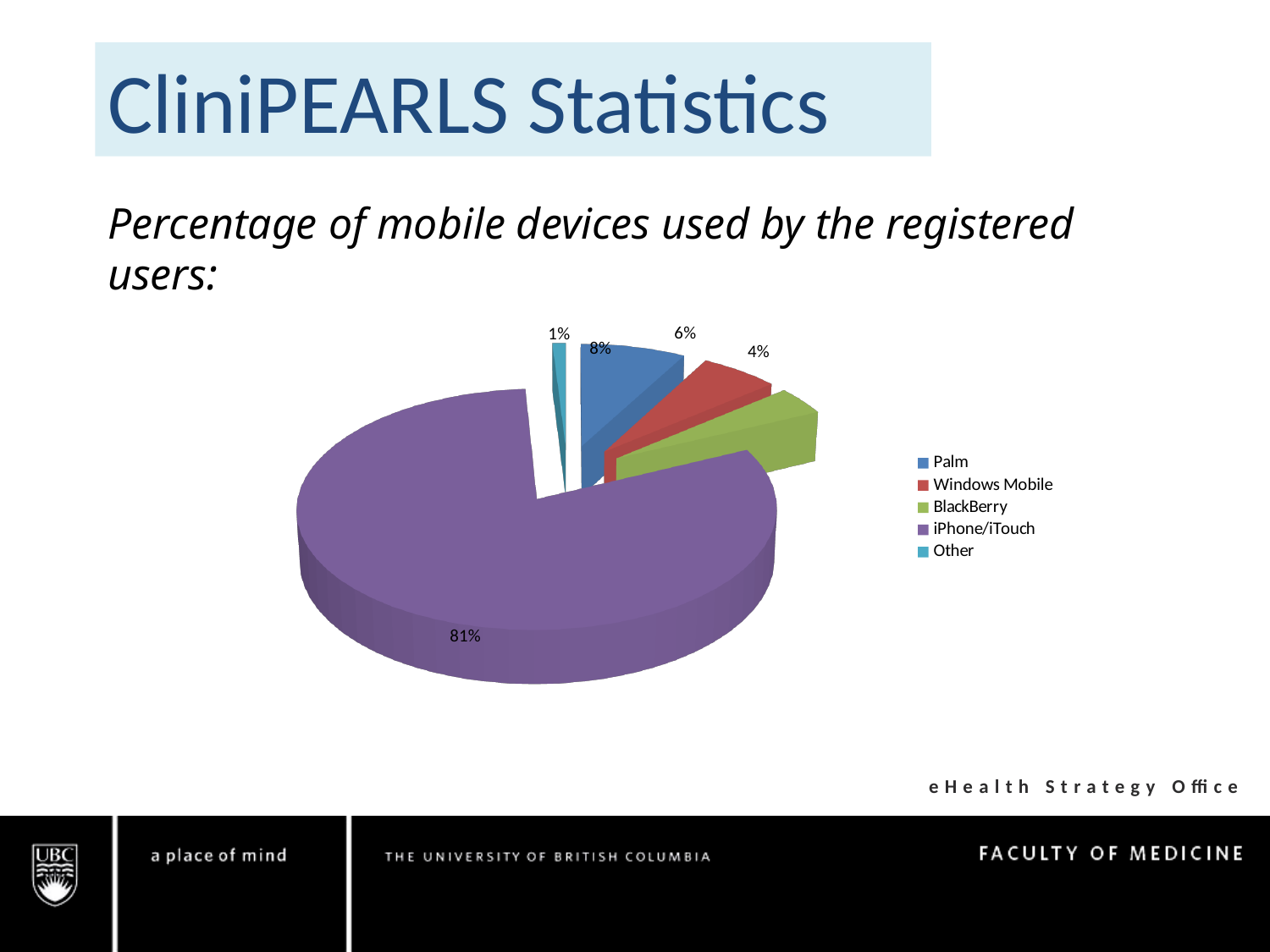
What percentage of registered users use a device in the Other category? 1% Which colour represents iPhone/iTouch in the pie chart? purple What kind of chart is shown on the slide? pie chart How many device categories does the legend list? 5 Which has a larger share, Palm or BlackBerry? Palm What is the difference in percentage points between the iPhone/iTouch share and the Palm share? 73 Which device category has the largest share of the pie? iPhone/iTouch What percentage of registered users use an iPhone/iTouch? 81% What percentage of registered users use a BlackBerry? 4% Which device category has the smallest share of the pie? Other What percentage of registered users use a Palm device? 8% What percentage of registered users use Windows Mobile? 6%